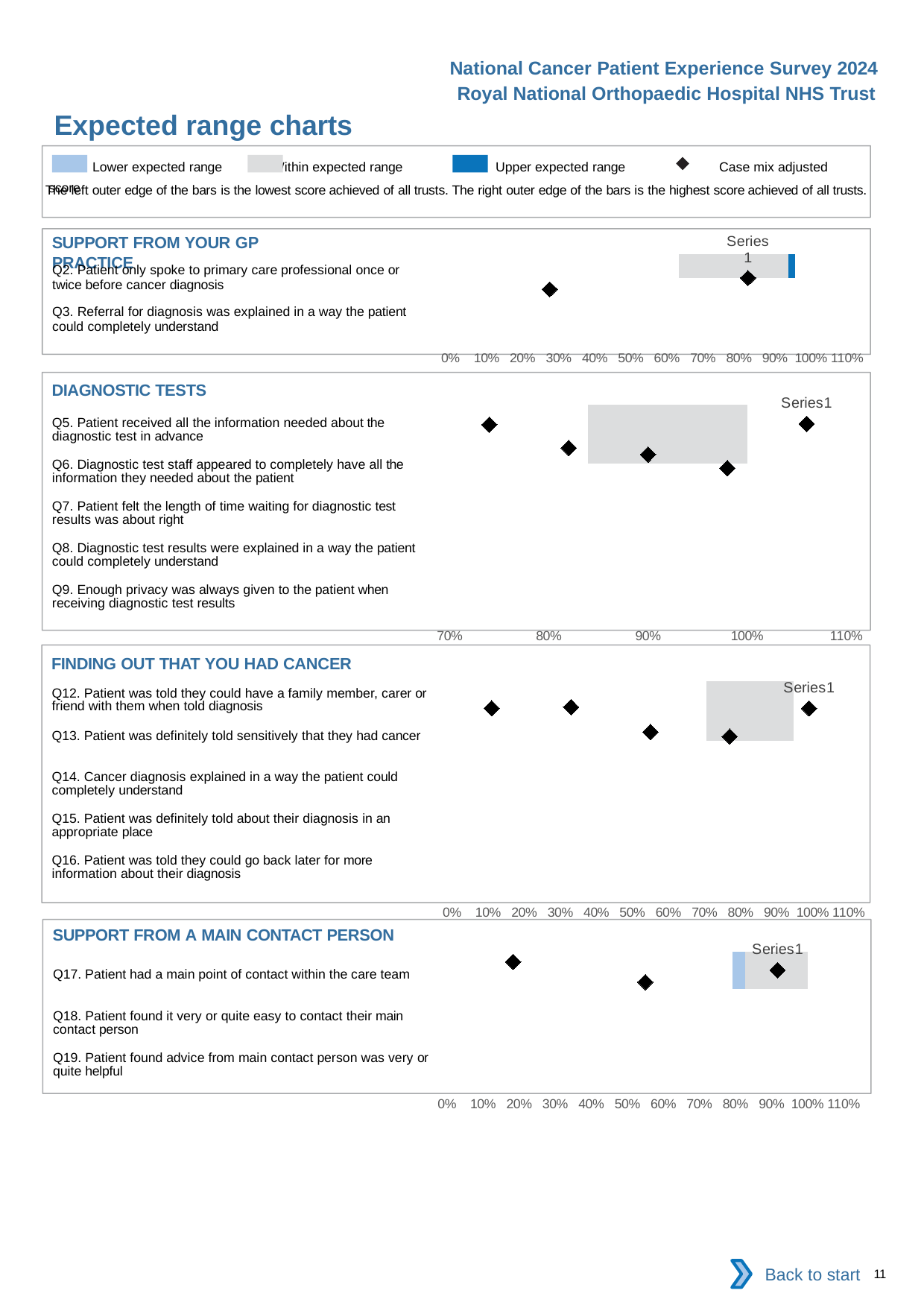
According to the legend, what does the diamond marker represent? Case mix adjusted score How many charts are shown on the slide? 4 What kind of chart is the DIAGNOSTIC TESTS chart? bar chart In the SUPPORT FROM YOUR GP PRACTICE chart, how many questions are listed? 2 In the FINDING OUT THAT YOU HAD CANCER chart, is the leftmost diamond marker greater or less than 20%? less In the SUPPORT FROM A MAIN CONTACT PERSON chart, how many diamond markers are plotted? 3 In the SUPPORT FROM A MAIN CONTACT PERSON chart, is the leftmost diamond marker greater or less than 30%? less What is the lowest x-axis tick label on the DIAGNOSTIC TESTS chart? 70% In the DIAGNOSTIC TESTS chart, is the rightmost diamond marker greater or less than 100%? greater